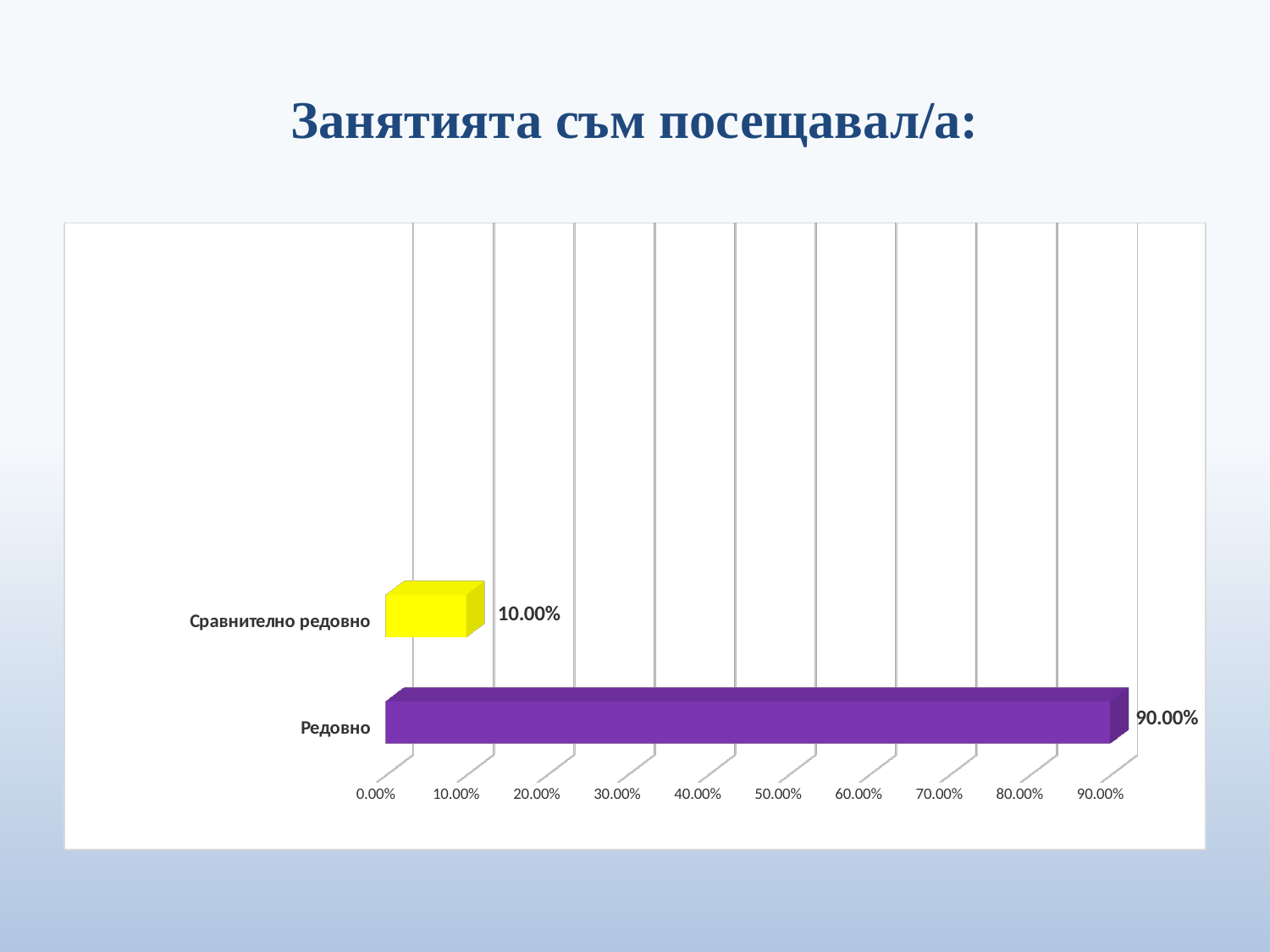
What colour is the bar for Сравнително редовно? yellow What is the value for Сравнително редовно? 10.00% What is the difference between the values for Редовно and Сравнително редовно? 80.00% What kind of chart is shown on the slide? bar chart What is the value for Редовно? 90.00% Which category has the highest value? Редовно Which category has the lowest value? Сравнително редовно Is the value for Сравнително редовно greater or less than 20.00%? less How many categories are shown in the chart? 2 What is the title of the slide? Занятията съм посещавал/а: Which is larger, the value for Редовно or the value for Сравнително редовно? Редовно Is the value for Редовно greater or less than 50.00%? greater